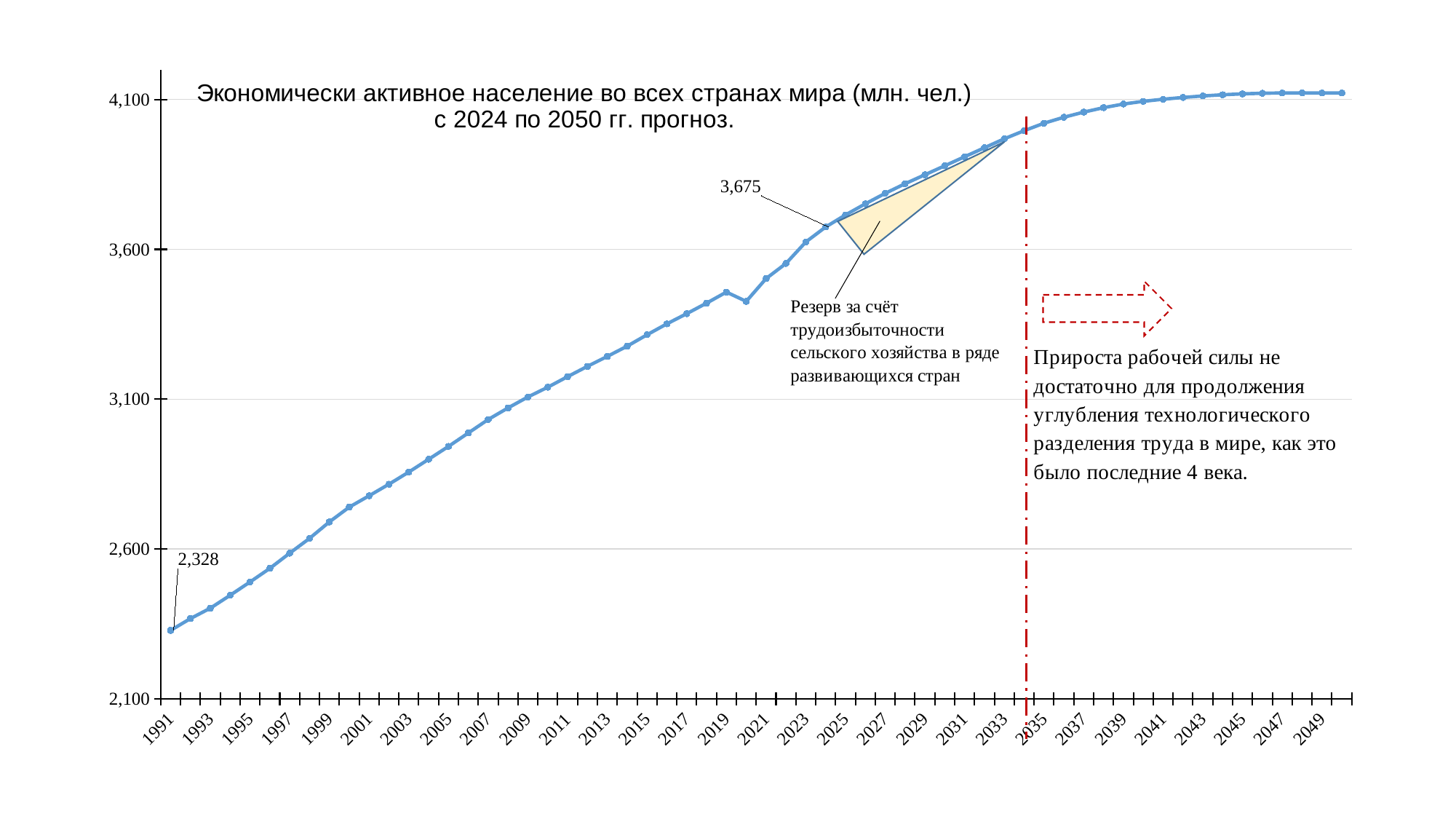
Is the value for 1995 greater or less than 2,600? less Does the economically active population generally rise or fall from 1991 to 2050? rise Which year has the lowest value on the chart? 1991 What is the title of the chart? Экономически активное население во всех странах мира (млн. чел.) с 2024 по 2050 гг. прогноз. What value is labelled on the line at 2024? 3,675 Is the value for 2019 greater or less than 3,600? less Which is larger, the value for 2019 or the value for 2020? 2019 What is the value of the economically active population in 1991? 2,328 Is the value for 2050 greater or less than 4,100? greater What is the difference between the labelled values for 2024 and 1991? 1,347 What kind of chart is shown on the slide? line chart